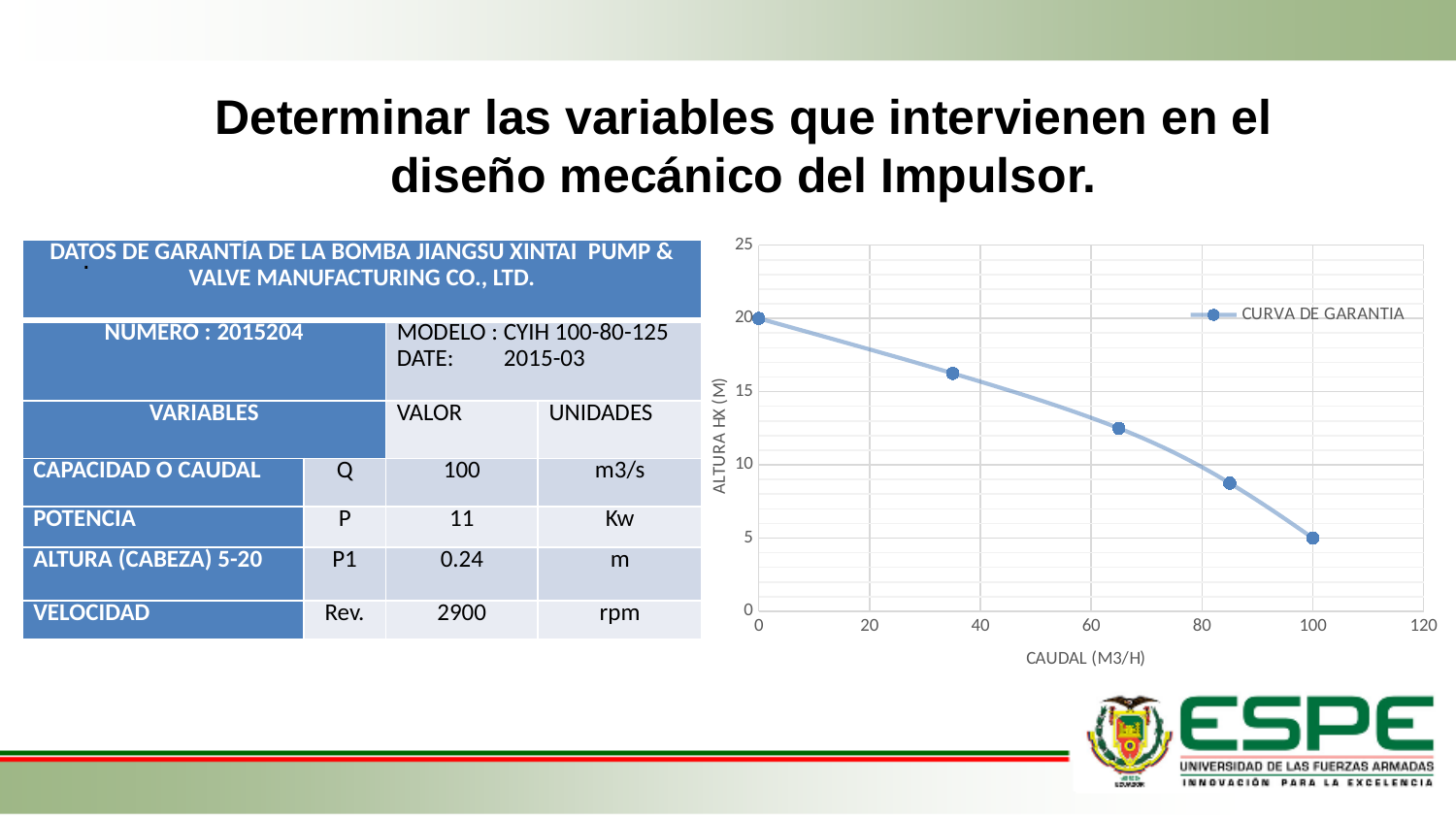
What is the name of the series shown in the chart legend? CURVA DE GARANTIA What is the ALTURA HX (M) value of the CURVA DE GARANTIA at CAUDAL 100? 5 How many series does the chart legend list? 1 How many data points are plotted on the CURVA DE GARANTIA line? 5 What is the ALTURA HX (M) value of the CURVA DE GARANTIA at CAUDAL 0? 20 What kind of chart is shown on the slide? line chart Is the ALTURA HX value of the fourth data point (near CAUDAL 85) greater or less than 10? less Which data point on the CURVA DE GARANTIA has the lowest ALTURA HX value? the point at CAUDAL 100 Do the values of the CURVA DE GARANTIA rise or fall as CAUDAL increases along the x axis? fall What is the title of the x axis of the chart? CAUDAL (M3/H) Which data point on the CURVA DE GARANTIA has the highest ALTURA HX value? the point at CAUDAL 0 Is the ALTURA HX value of the second data point (near CAUDAL 35) greater or less than 15? greater